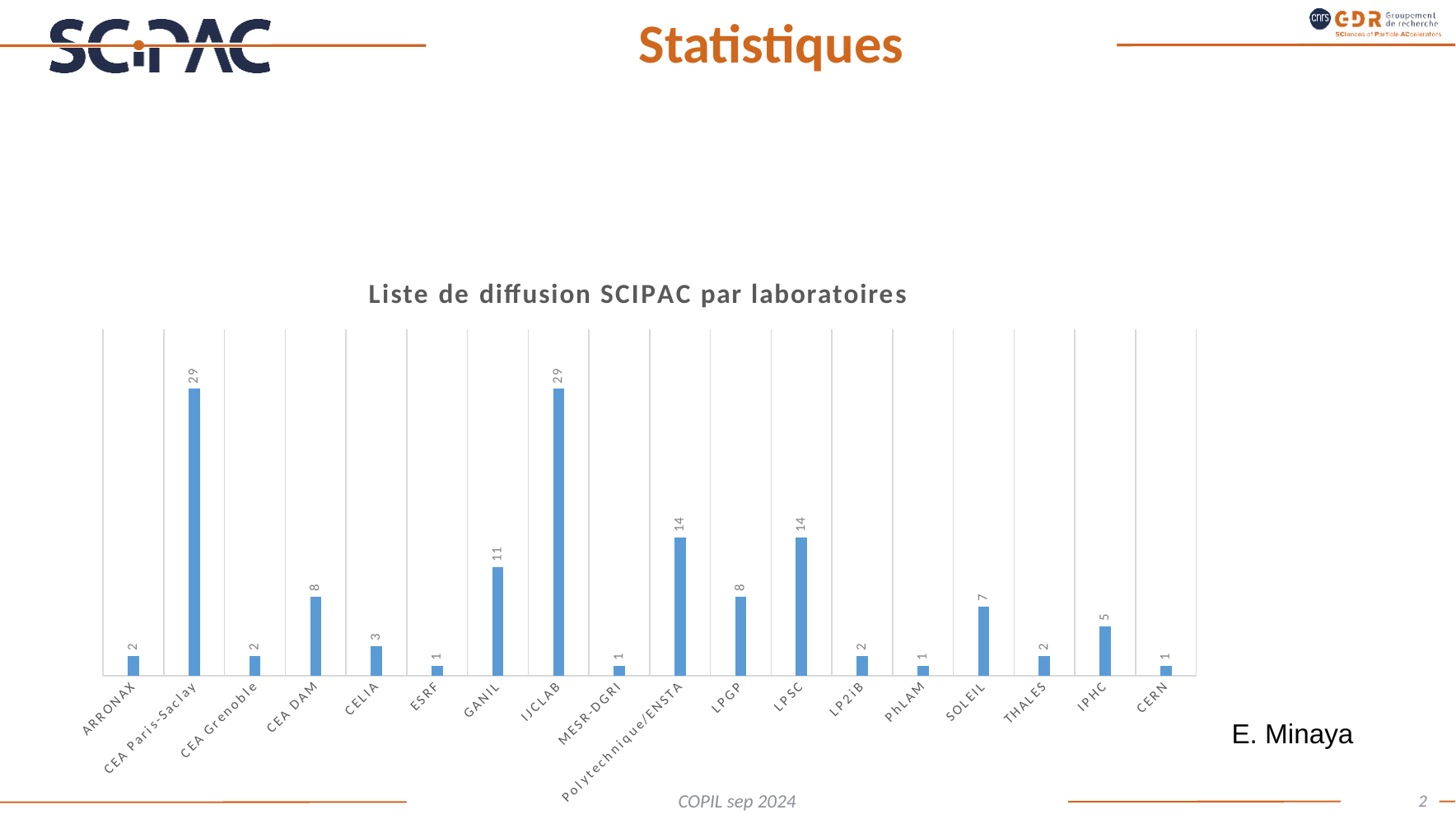
Which has a larger value, LPSC or SOLEIL? LPSC What is the highest value shown in the chart? 29 What is the value for CELIA? 3 What is the value for Polytechnique/ENSTA? 14 Which has a larger value, CEA DAM or IPHC? CEA DAM What is the value for IPHC? 5 What is the value for SOLEIL? 7 What is the difference between the values for IJCLAB and LPSC? 15 What is the difference between the values for GANIL and CEA DAM? 3 How many laboratories are shown on the x axis? 18 What is the value for GANIL? 11 What type of chart is shown on the slide? Bar chart